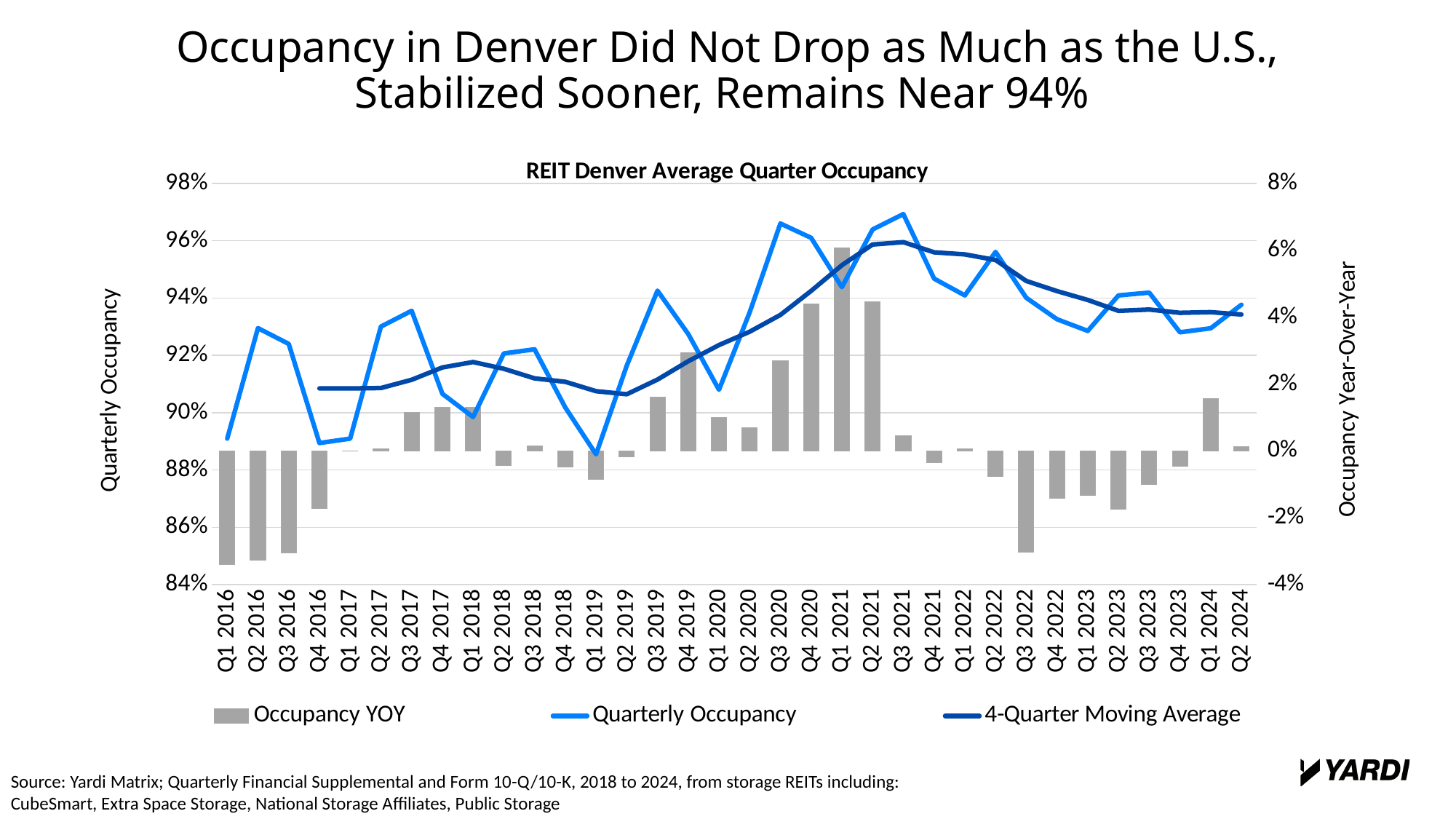
Is the Quarterly Occupancy value for Q3 2021 greater or less than 96%? greater What is the title of the chart? REIT Denver Average Quarter Occupancy Is the Quarterly Occupancy value for Q2 2024 greater or less than 92%? greater What kind of chart is this? Combined bar and line chart Which quarter has the highest Occupancy YOY bar? Q1 2021 Does the 4-Quarter Moving Average rise or fall from Q2 2021 to Q2 2024? fall How many quarters are shown on the x axis? 34 What is the label of the right-hand vertical axis? Occupancy Year-Over-Year Is the Occupancy YOY value for Q3 2022 greater or less than -2%? less How many series does the legend list? 3 Which has the higher Quarterly Occupancy, Q2 2016 or Q4 2016? Q2 2016